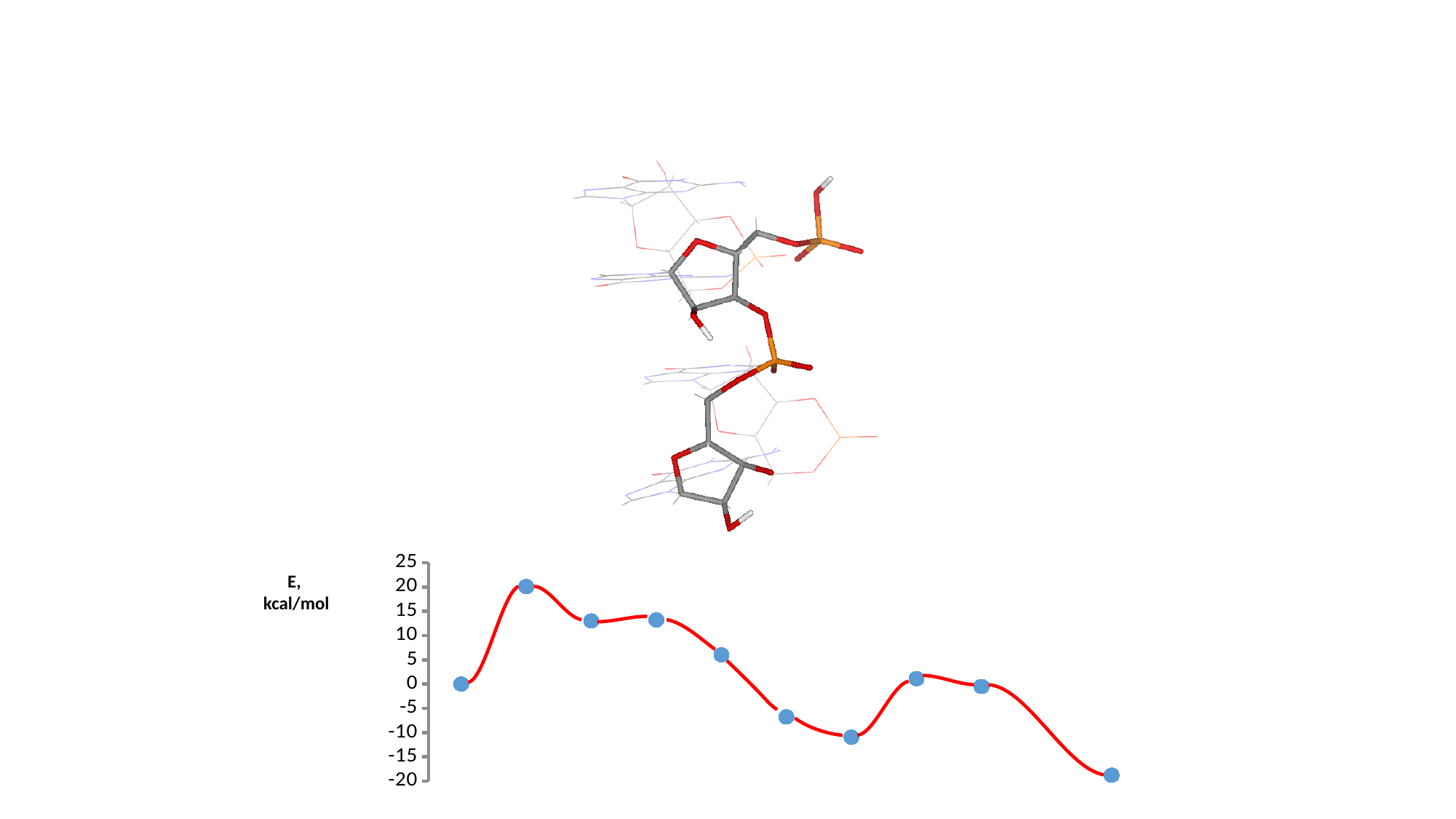
Which data point on the line chart has the highest energy value? the second point What kind of chart is shown at the bottom of the slide? line chart Is the value of the last data point on the line chart greater or less than -15? less Which is larger on the line chart: the value of the second data point or the value of the last data point? the second data point Which data point on the line chart has the lowest energy value? the last (tenth) point What is the label on the vertical axis of the line chart? E, kcal/mol Is the value of the seventh data point on the line chart greater or less than -5? less Is the value of the second data point on the line chart greater or less than 15? greater Overall, do the values on the line chart rise or fall from the first point to the last point? fall How many data points are plotted on the line chart? 10 What colour is the line connecting the data points on the chart? red